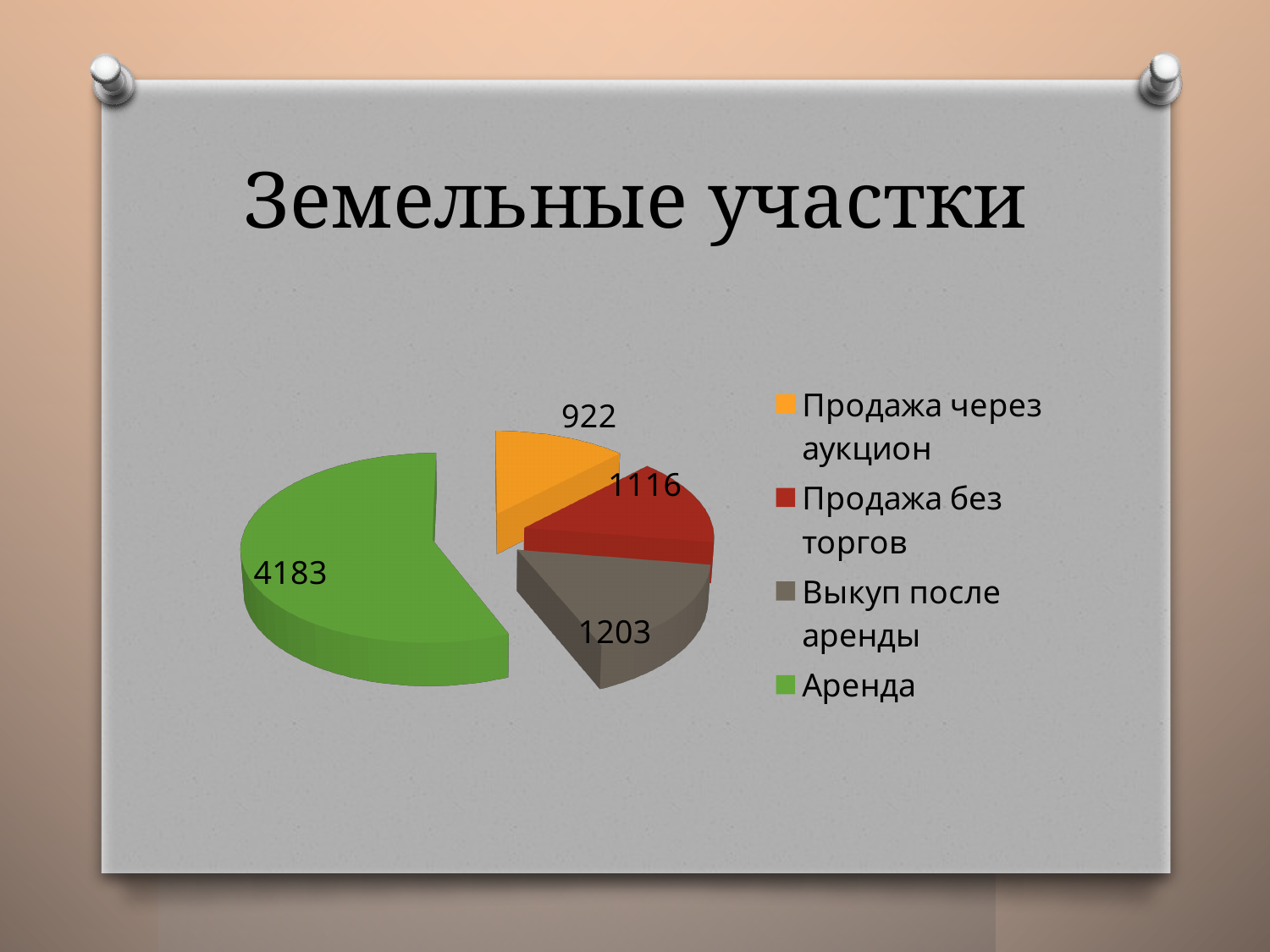
Which category has the smallest slice? Продажа через аукцион What is the value for Продажа через аукцион? 922 What is the value for Продажа без торгов? 1116 What is the total of all slices in the pie chart? 7424 How many categories does the pie chart have? 4 Which category has the largest slice? Аренда What type of chart is shown on the slide? Pie chart What is the difference between the values for Аренда and Выкуп после аренды? 2980 What is the value for Аренда? 4183 What is the value for Выкуп после аренды? 1203 Which is larger, Продажа без торгов or Выкуп после аренды? Выкуп после аренды What is the title of the chart on the slide? Земельные участки